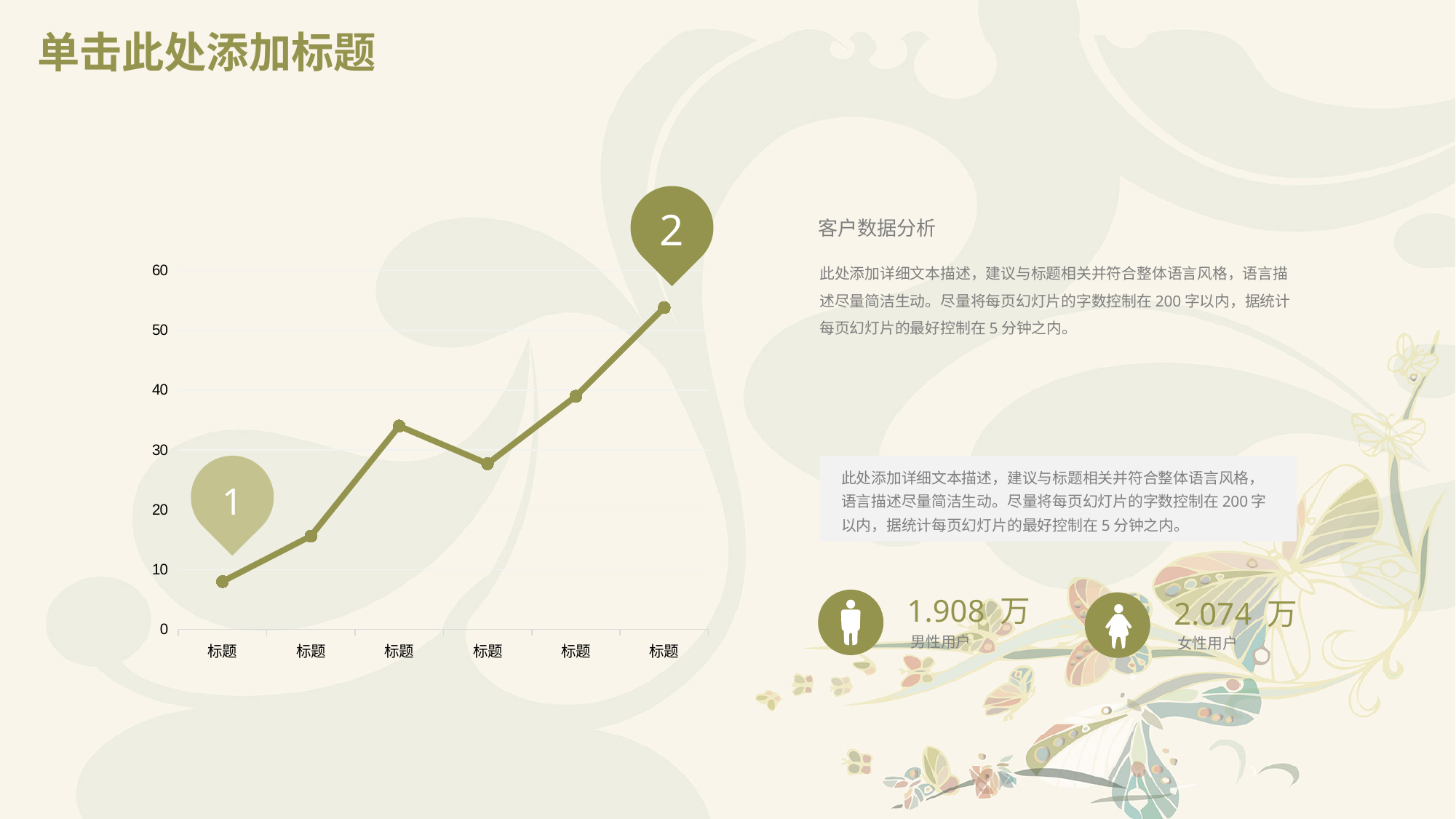
Which is larger on the line chart, the third point or the fourth point? the third point What kind of chart is shown on the slide? line chart Which is larger on the line chart, the second point or the fifth point? the fifth point Is the value of the fourth point on the line chart greater or less than 30? less Which point on the line chart has the lowest value? the first point Which point on the line chart has the highest value? the sixth (last) point What is the highest value shown on the vertical axis of the line chart? 60 How many data points are plotted on the line chart? 6 Is the value of the first point on the line chart greater or less than 10? less Is the value of the last point on the line chart greater or less than 50? greater Do the values on the line chart generally rise or fall from left to right? rise